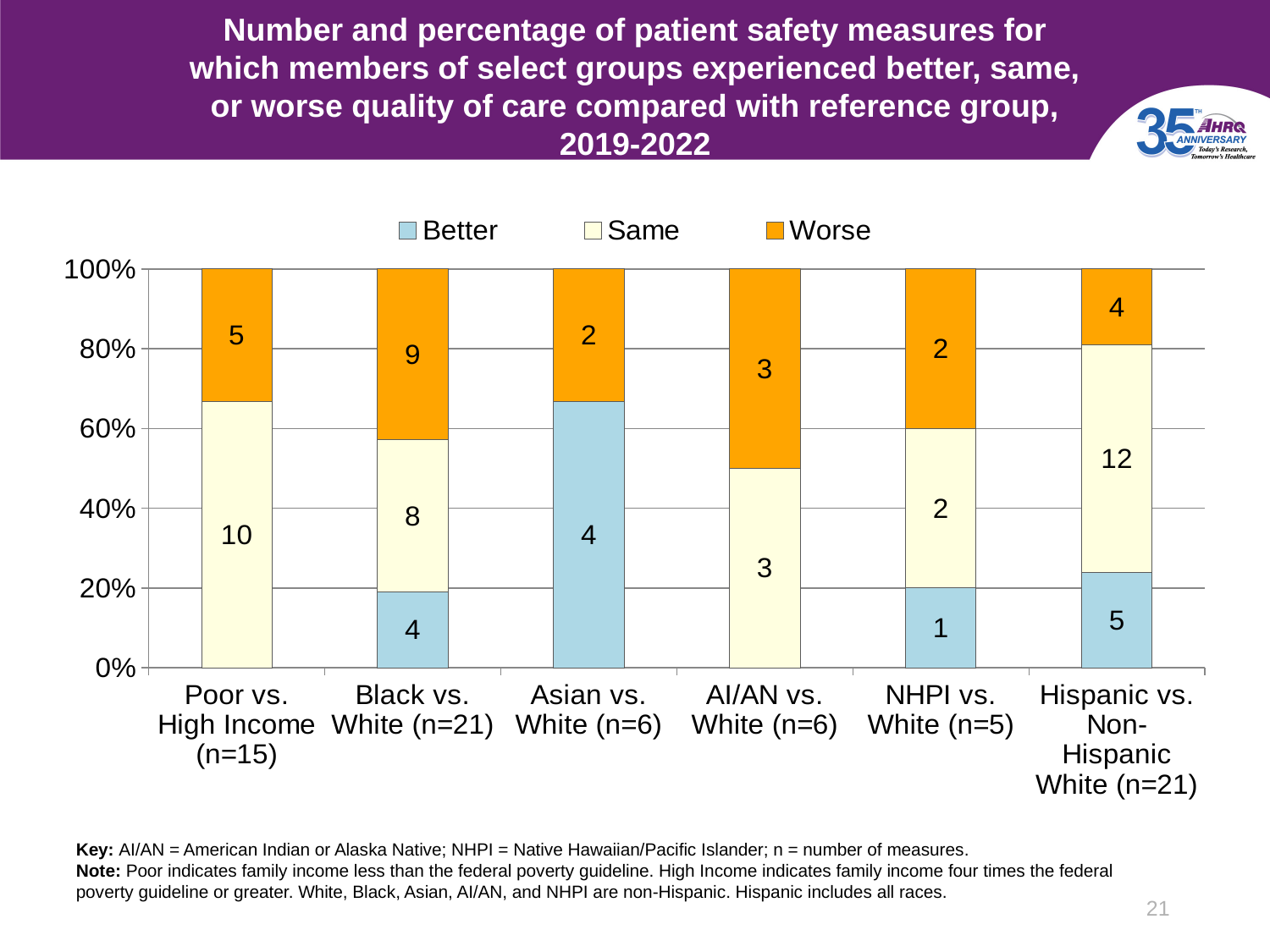
What type of chart is shown on the slide? Stacked bar chart What is the difference between the 'Same' and 'Worse' counts for Poor vs. High Income? 5 Which group comparison has the largest number of 'Same' measures? Hispanic vs. Non-Hispanic White (n=21) How many patient safety measures were 'Same' for Black vs. White? 8 How many group comparisons are shown on the x axis? 6 How many series does the legend list? 3 How many measures were 'Better' for NHPI vs. White? 1 What is the total number of measures in the Black vs. White bar (Better + Same + Worse)? 21 How many measures were 'Better' for Asian vs. White? 4 Which is larger for Black vs. White: the 'Worse' count or the 'Same' count? Worse How many measures were 'Worse' for Hispanic vs. Non-Hispanic White? 4 Which group comparison has the largest number of 'Worse' measures? Black vs. White (n=21)